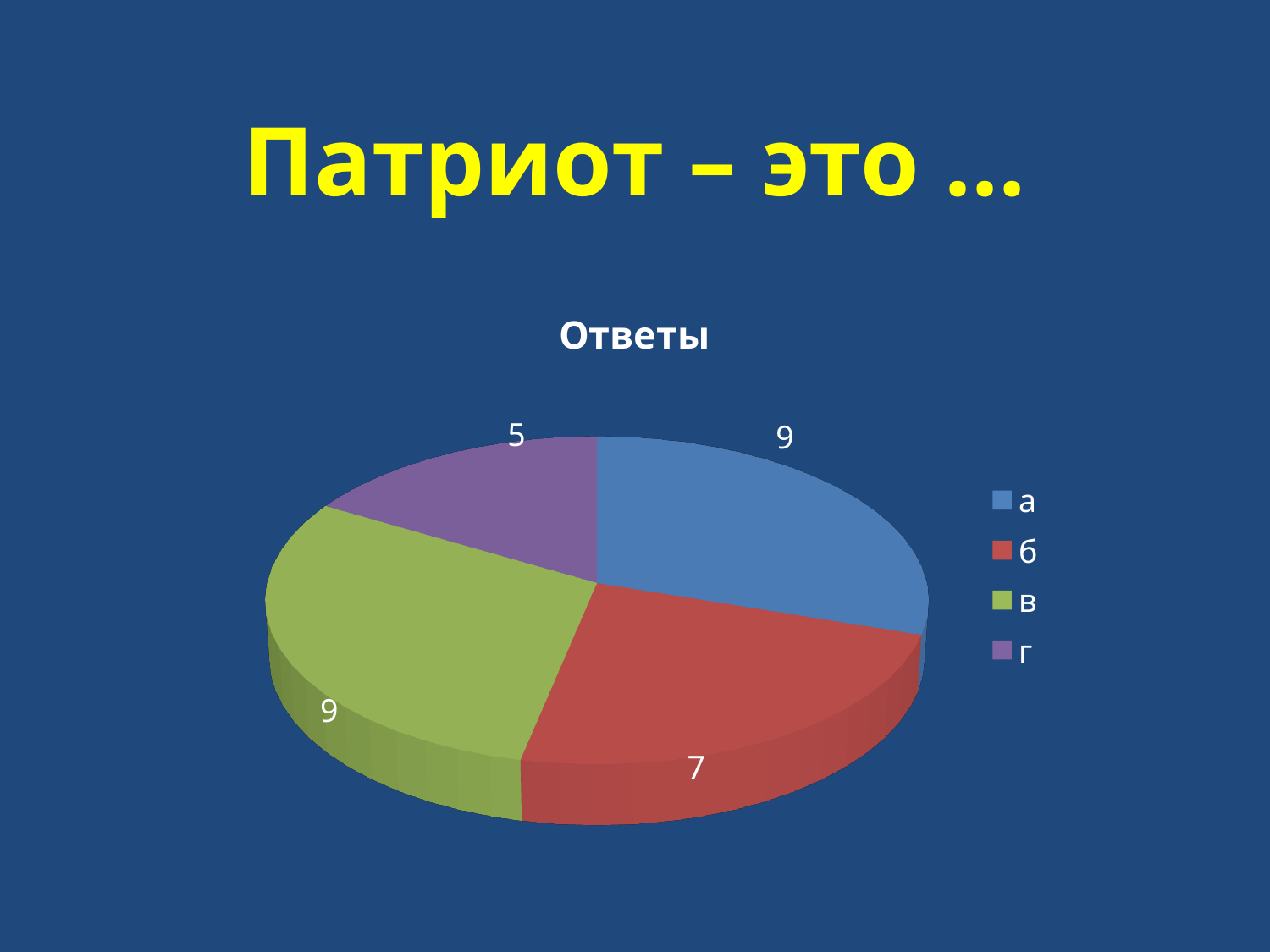
What share of the pie does category а represent? 30% What is the title of the chart? Ответы What kind of chart is shown on the slide? pie chart What is the value for category в? 9 What is the value for category б? 7 What is the difference between the values for а and г? 4 Which category has the lowest value? г What is the difference between the values for б and г? 2 What is the value for category г? 5 Which is larger, the value for б or the value for г? б How many categories does the pie chart have? 4 What is the value for category а? 9